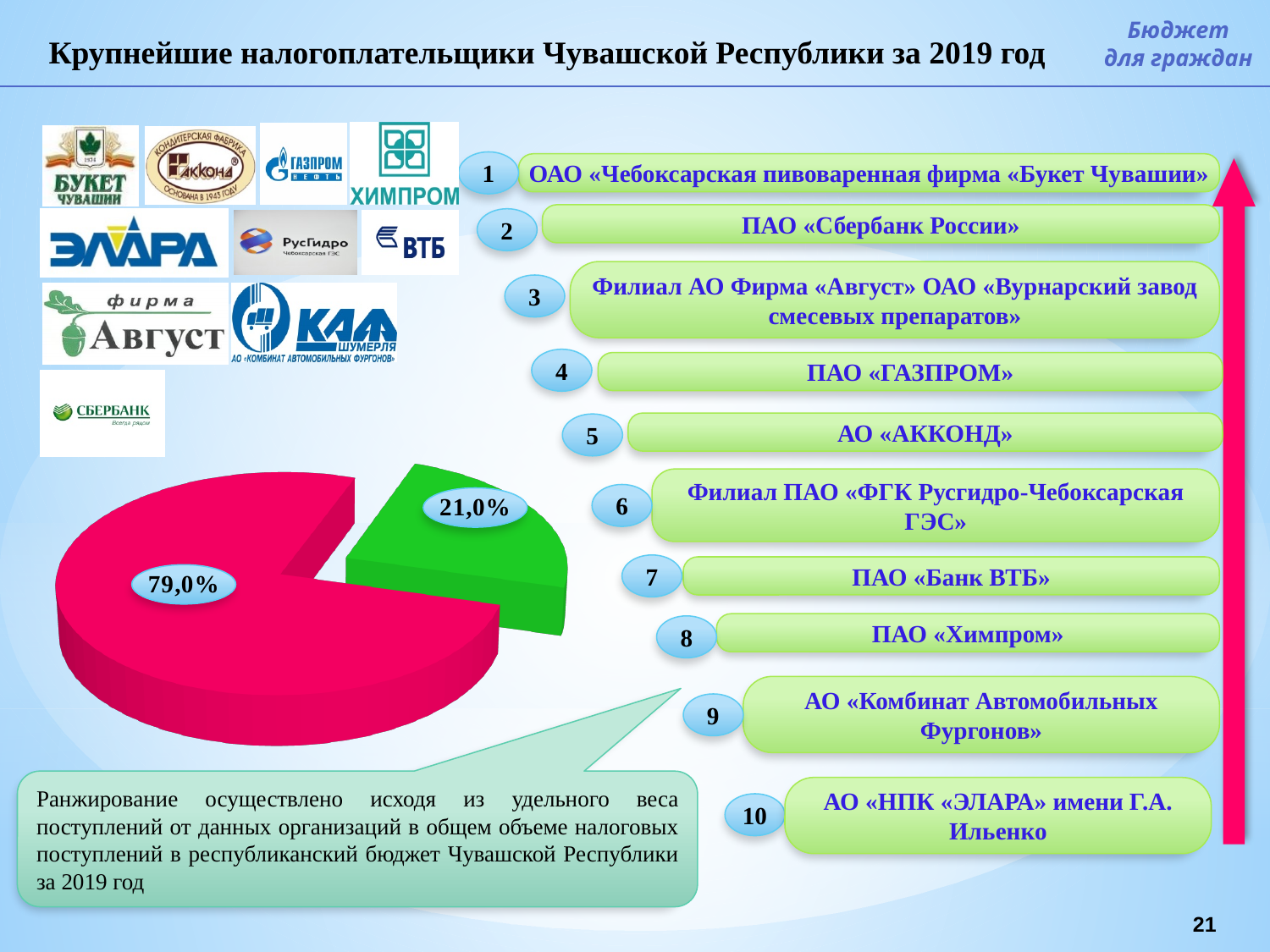
Which slice of the pie chart is the smallest? the green slice (21,0%) What value is shown on the red slice of the pie chart? 79,0% Does the pie chart have a legend? No Is the value of the red slice of the pie chart greater or less than 75%? greater Which slice of the pie chart is pulled out (exploded) from the rest? the green slice What kind of chart is shown on the left side of the slide? pie chart How many slices does the pie chart have? 2 Is the value of the green slice of the pie chart greater or less than 25%? less What is the difference in percentage points between the red slice and the green slice of the pie chart? 58,0 Which is larger in the pie chart, the red slice or the green slice? the red slice What value is shown on the green slice of the pie chart? 21,0% Which slice of the pie chart is the largest? the red slice (79,0%)